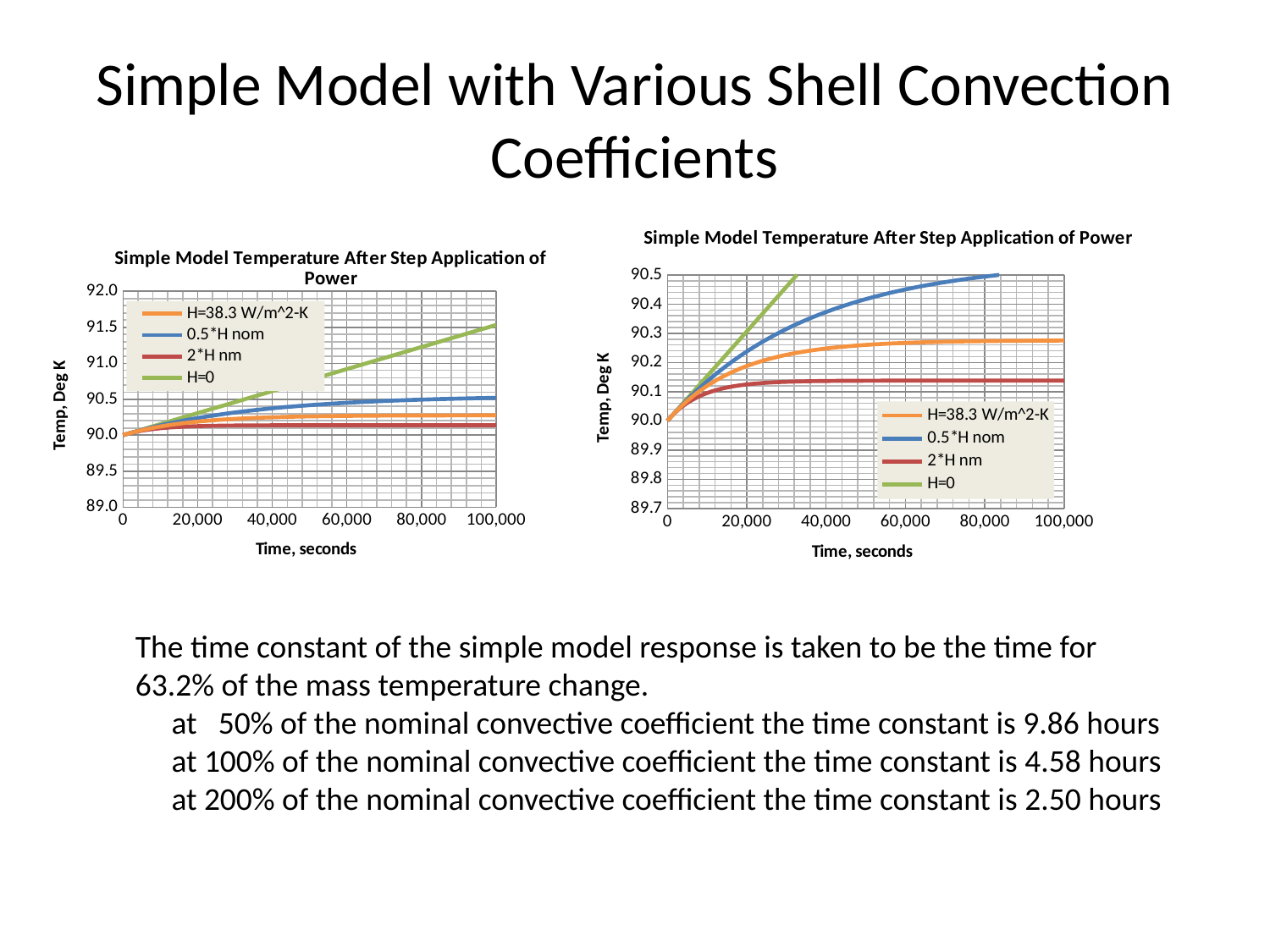
How many series does the legend of the right chart list? 4 In the left chart, which series has the lowest temperature at 100,000 seconds? 2*H nm In the left chart, which series has the highest temperature at 100,000 seconds? H=0 What is the x-axis title of the right chart? Time, seconds What is the y-axis title of the left chart? Temp, Deg K In the right chart, does the H=0 series rise or fall as time increases? rise In the right chart, is the value for 2*H nm at 100,000 seconds greater or less than 90.2? less In the right chart, is the value for H=38.3 W/m^2-K at 100,000 seconds greater or less than 90.2? greater What kind of chart is the left chart on the slide? line chart In the left chart, what is the temperature of all series at time 0? 90.0 In the right chart, which is larger at 60,000 seconds, the value for 0.5*H nom or the value for 2*H nm? 0.5*H nom In the left chart, is the value for H=0 at 100,000 seconds greater or less than 91.0? greater